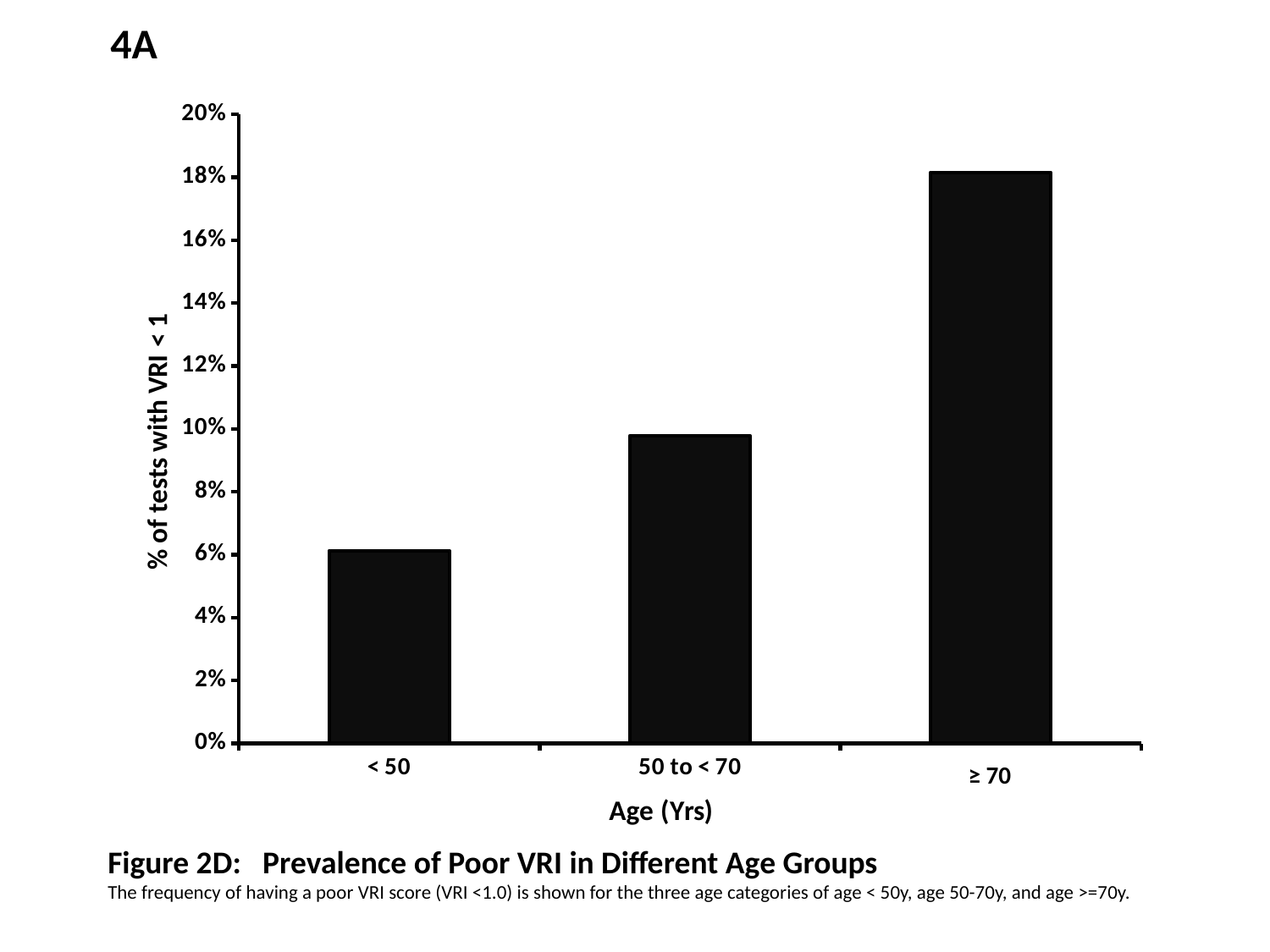
How many age groups are shown in the chart? 3 Is the value for the < 50 age group greater or less than 8%? less Which age group has a higher percentage of tests with VRI < 1: < 50 or 50 to < 70? 50 to < 70 Which age group has the lowest percentage of tests with VRI < 1? < 50 Which age group has the highest percentage of tests with VRI < 1? ≥ 70 Is the value for the ≥ 70 age group greater or less than 16%? greater Is the value for the 50 to < 70 age group greater or less than 8%? greater What type of chart is shown on the slide? Bar chart What is the title of the figure given in the caption below the chart? Figure 2D: Prevalence of Poor VRI in Different Age Groups Do the values rise or fall as age increases along the x axis? Rise What is the label of the y axis? % of tests with VRI < 1